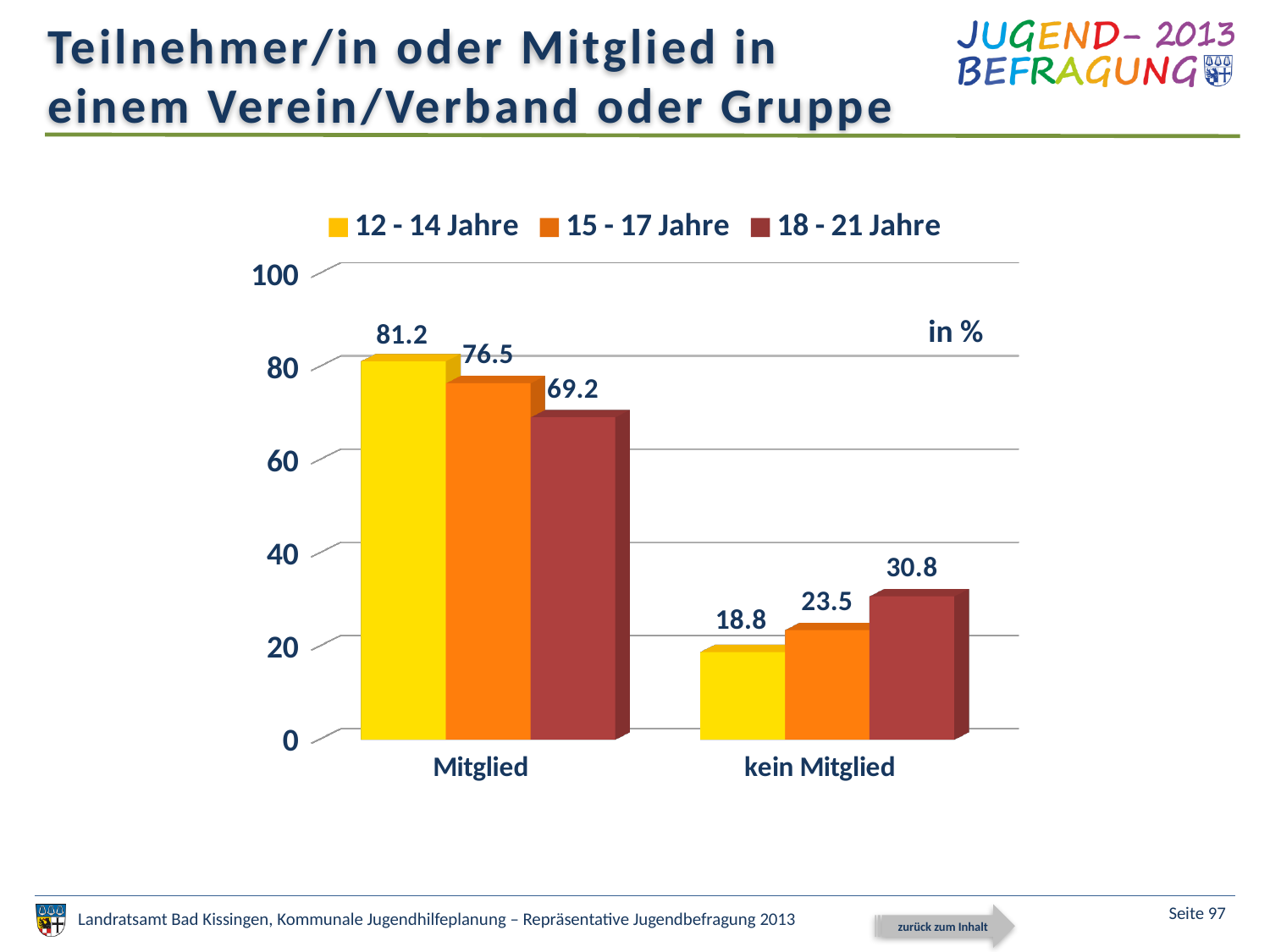
How many series does the legend list? 3 What is the value for the 15 - 17 Jahre series in the Mitglied category? 76.5 What is the difference between the 18 - 21 Jahre and 12 - 14 Jahre values in the kein Mitglied category? 12 What is the value for the 18 - 21 Jahre series in the kein Mitglied category? 30.8 What kind of chart is shown on the slide? Bar chart Which age group has the lowest value in the kein Mitglied category? 12 - 14 Jahre How many categories are shown on the x axis? 2 What is the difference between the 12 - 14 Jahre and 18 - 21 Jahre values in the Mitglied category? 12 Which age group has the highest value in the Mitglied category? 12 - 14 Jahre What is the value for the 12 - 14 Jahre series in the Mitglied category? 81.2 Which is larger: the 15 - 17 Jahre value for Mitglied or the 15 - 17 Jahre value for kein Mitglied? Mitglied What unit is indicated for the values in the chart? %